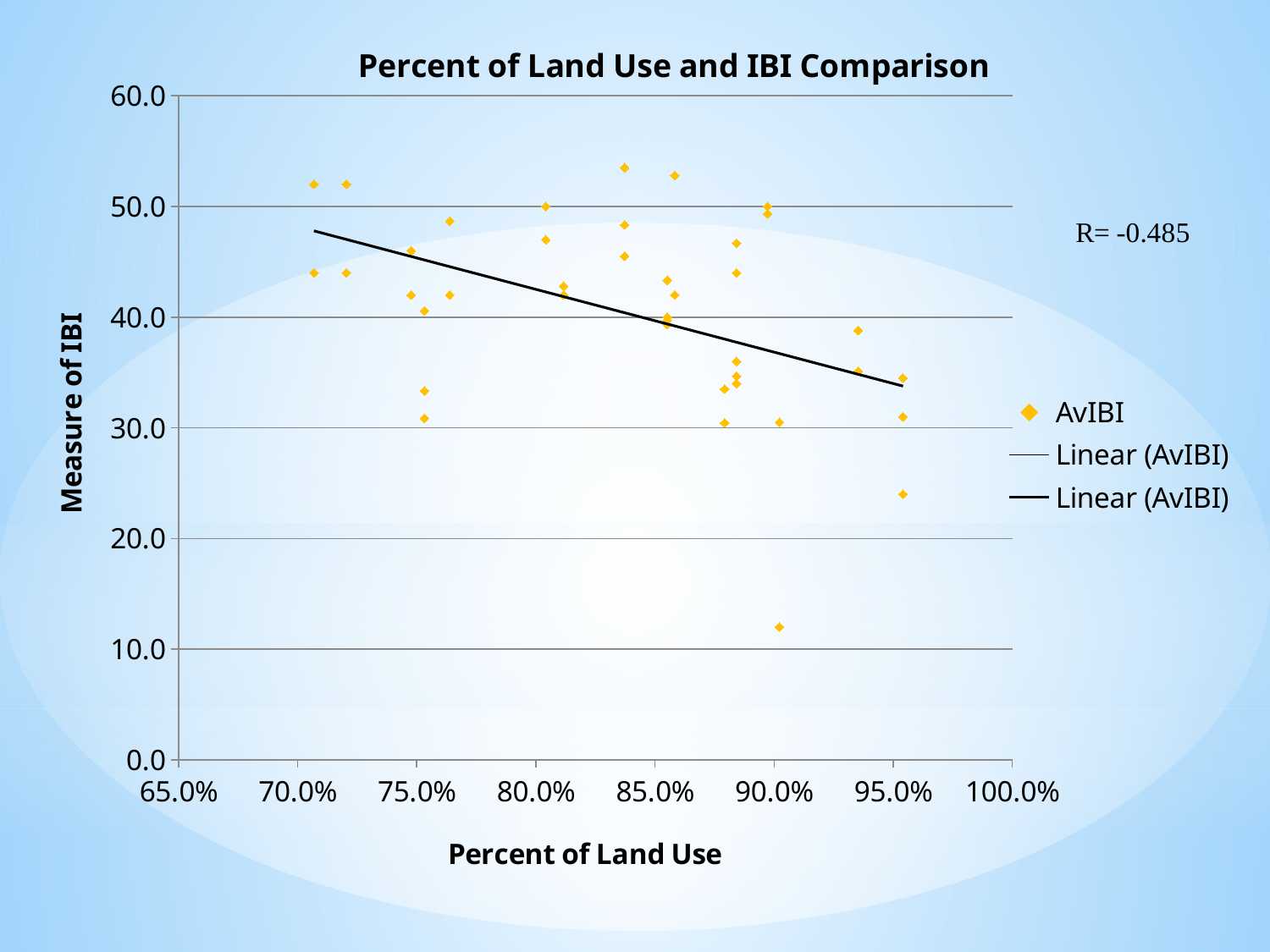
What is the label of the vertical axis? Measure of IBI Is the lowest plotted AvIBI point located at a Percent of Land Use greater or less than 85.0%? greater Is the lowest plotted AvIBI point greater or less than 20.0? less What is the maximum value shown on the vertical axis? 60.0 What is the minimum value shown on the horizontal axis? 65.0% What kind of chart is shown on the slide? Scatter chart What correlation coefficient (R) is printed on the slide? R= -0.485 Is the highest plotted AvIBI point greater or less than 50.0? greater Does the linear trend line rise or fall as Percent of Land Use increases? Fall What is the title of the chart? Percent of Land Use and IBI Comparison How many entries does the chart's legend list? 3